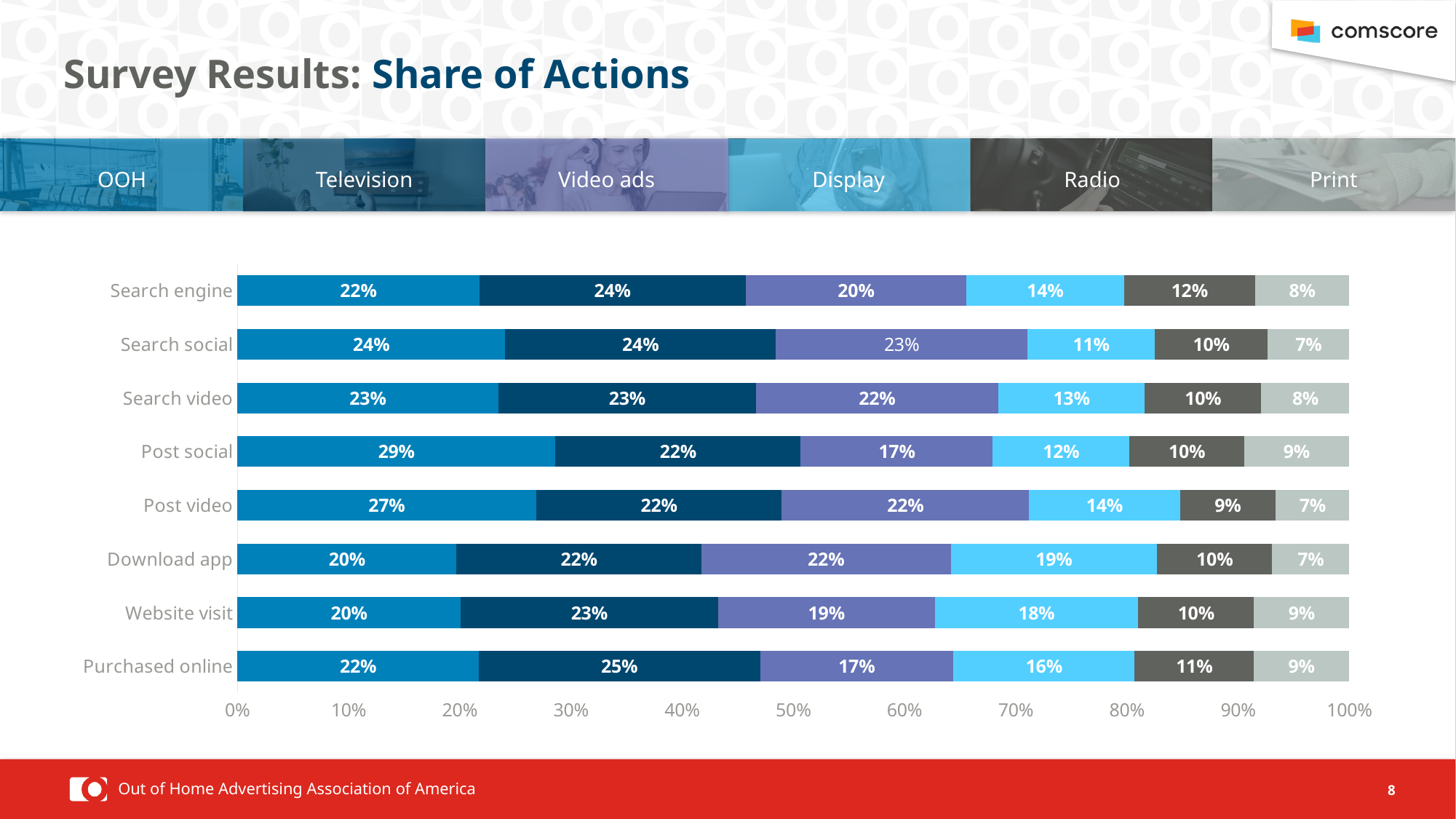
What is the Print share for Search social? 7% Which action has the lowest Display share? Search social For Search engine, which is larger: the OOH share or the Television share? Television Which action has the highest OOH share? Post social What type of chart is shown on the slide? Stacked bar chart How many media series are shown in the chart? 6 What is the total of the Search engine bar? 100% For Purchased online, how much larger is the Television share than the OOH share? 3% What is the OOH share for Post social? 29% What is the Radio share for Search engine? 12% What is the Display share for Download app? 19% How many actions (categories) are shown in the chart? 8